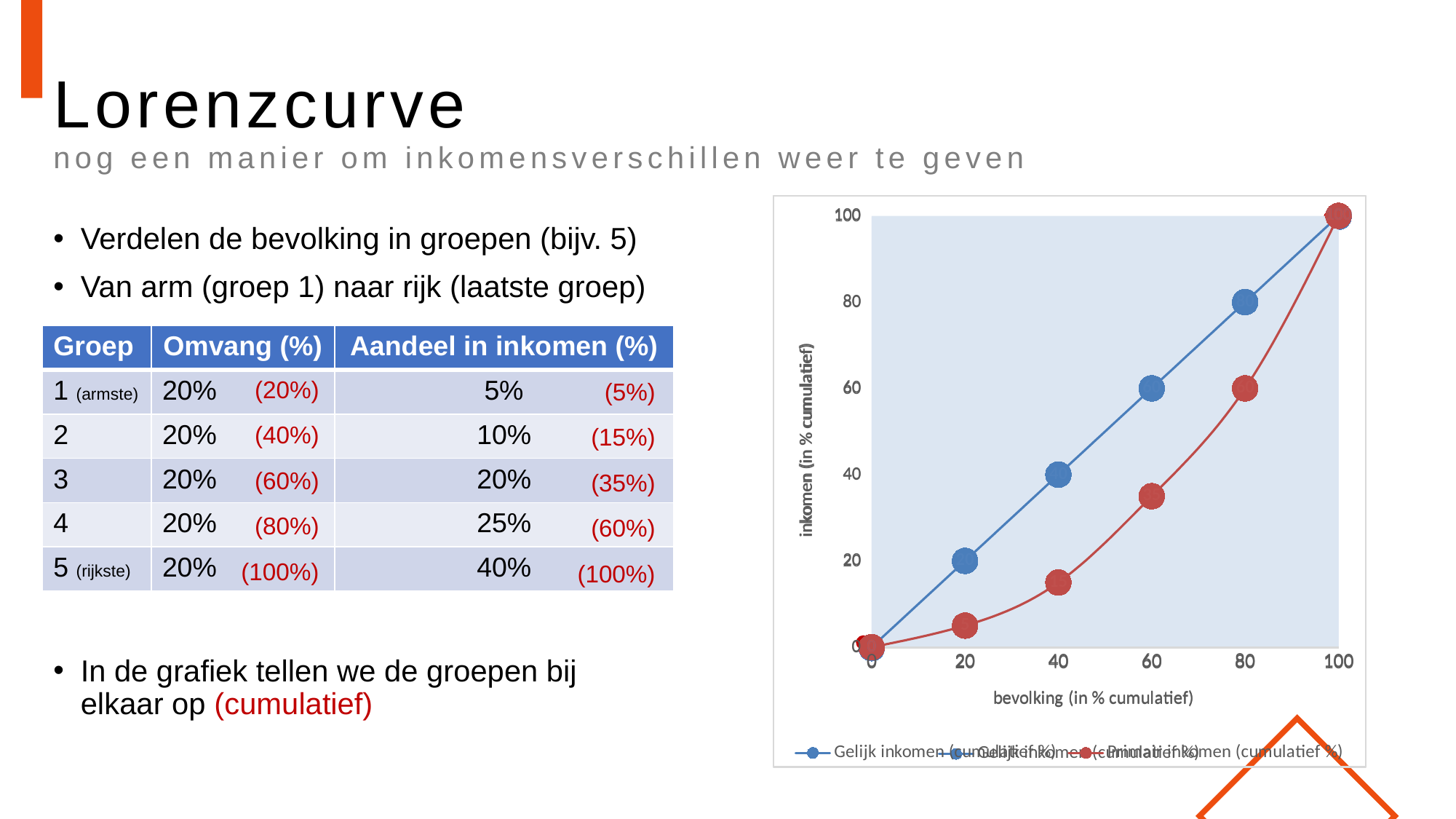
What is the value of the blue line (Gelijk inkomen) at 80 on the x axis? 80 Is the value of the red line (Primair inkomen) at 60 on the x axis greater or less than 40? less What is the value of the red line (Primair inkomen) at 80 on the x axis? 60 What is the title of the x axis of the chart? bevolking (in % cumulatief) Is the value of the red line (Primair inkomen) at 40 on the x axis greater or less than 20? less What is the value of the blue line (Gelijk inkomen) at 60 on the x axis? 60 What kind of chart is shown on the slide? line chart What is the value of the red line (Primair inkomen) at 100 on the x axis? 100 Do the values of the red line rise or fall as the x axis increases? rise How many data points are plotted on the red line? 6 At 60 on the x axis, which line has the higher value, the blue line or the red line? the blue line What is the title of the y axis of the chart? inkomen (in % cumulatief)